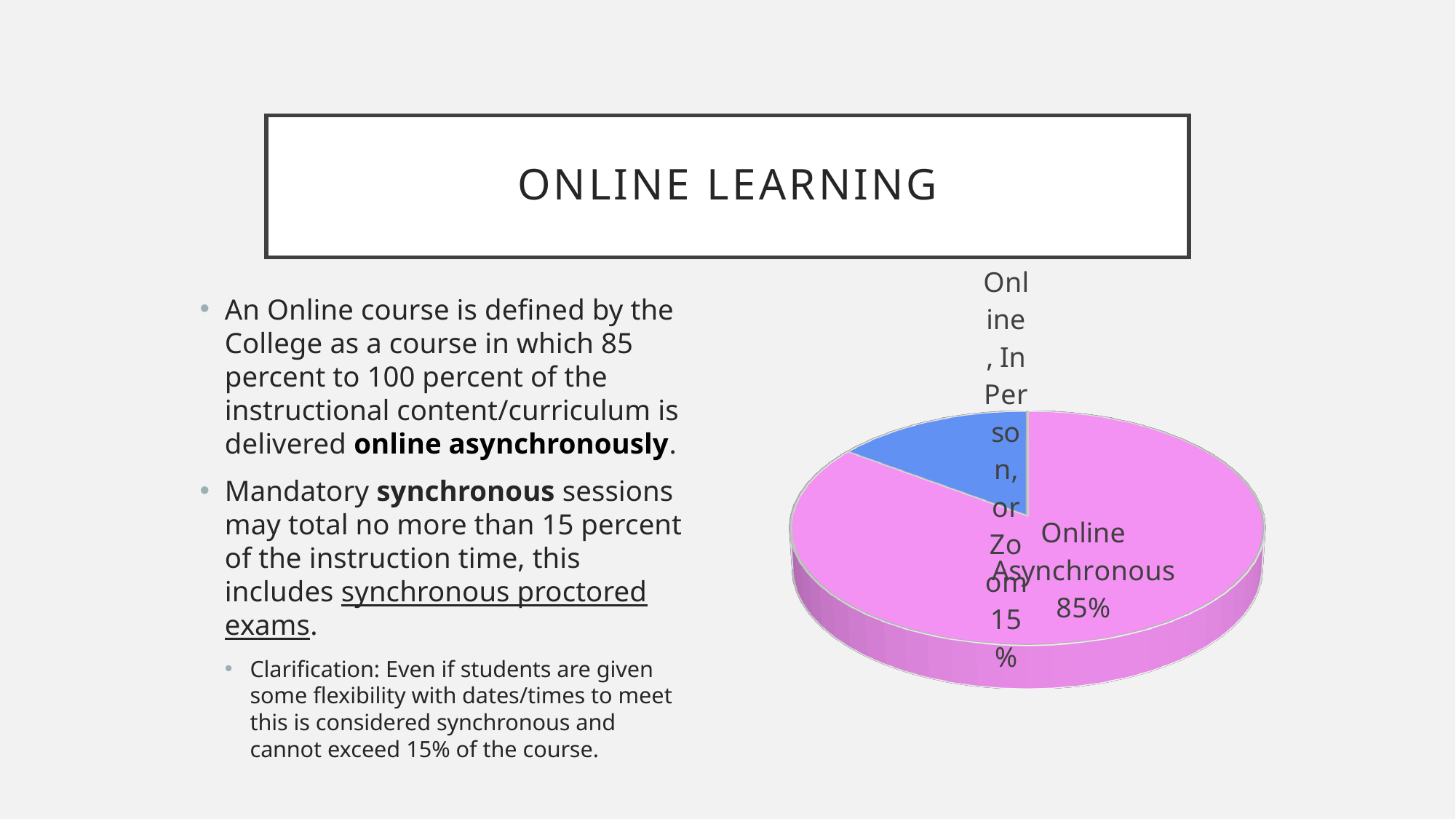
What colour is the 'Online, In Person, or Zoom' slice? blue What kind of chart is shown on the slide? pie chart What colour is the Online Asynchronous slice? pink What percentage does the Online Asynchronous slice represent? 85% What is the difference in percentage points between the Online Asynchronous slice and the 'Online, In Person, or Zoom' slice? 70 Which is larger: the Online Asynchronous slice or the 'Online, In Person, or Zoom' slice? Online Asynchronous How many slices does the pie chart have? 2 What percentage does the 'Online, In Person, or Zoom' slice represent? 15% Which slice of the pie chart is the largest? Online Asynchronous What share of the pie does the Online Asynchronous slice take up? 85% Which slice of the pie chart is the smallest? Online, In Person, or Zoom